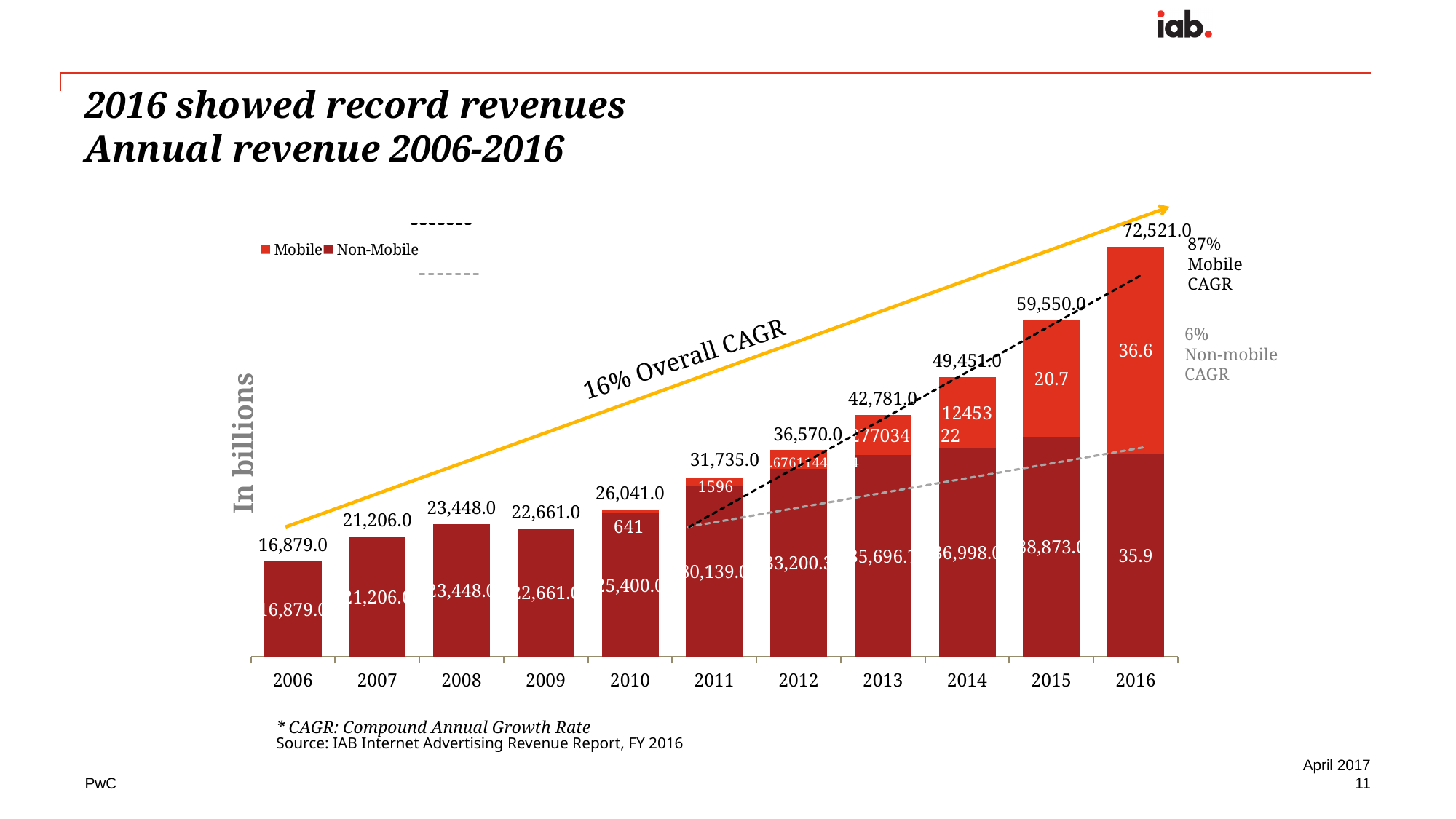
How many series does the chart legend list? 2 Which year has the highest total annual revenue? 2016 What is the Non-Mobile value labelled on the 2011 bar? 30,139.0 What is the total annual revenue shown above the bar for 2006? 16,879.0 Which year has the lowest total annual revenue? 2006 What overall CAGR is labelled along the yellow arrow on the chart? 16% What kind of chart is shown on the slide? Stacked bar chart What is the total annual revenue shown above the bar for 2016? 72,521.0 What is the difference between the total revenue for 2016 and the total revenue for 2015? 12,971.0 Which year has the larger total revenue, 2008 or 2009? 2008 What is the Mobile value labelled on the 2010 bar? 641 How many years are shown on the x axis of the chart? 11